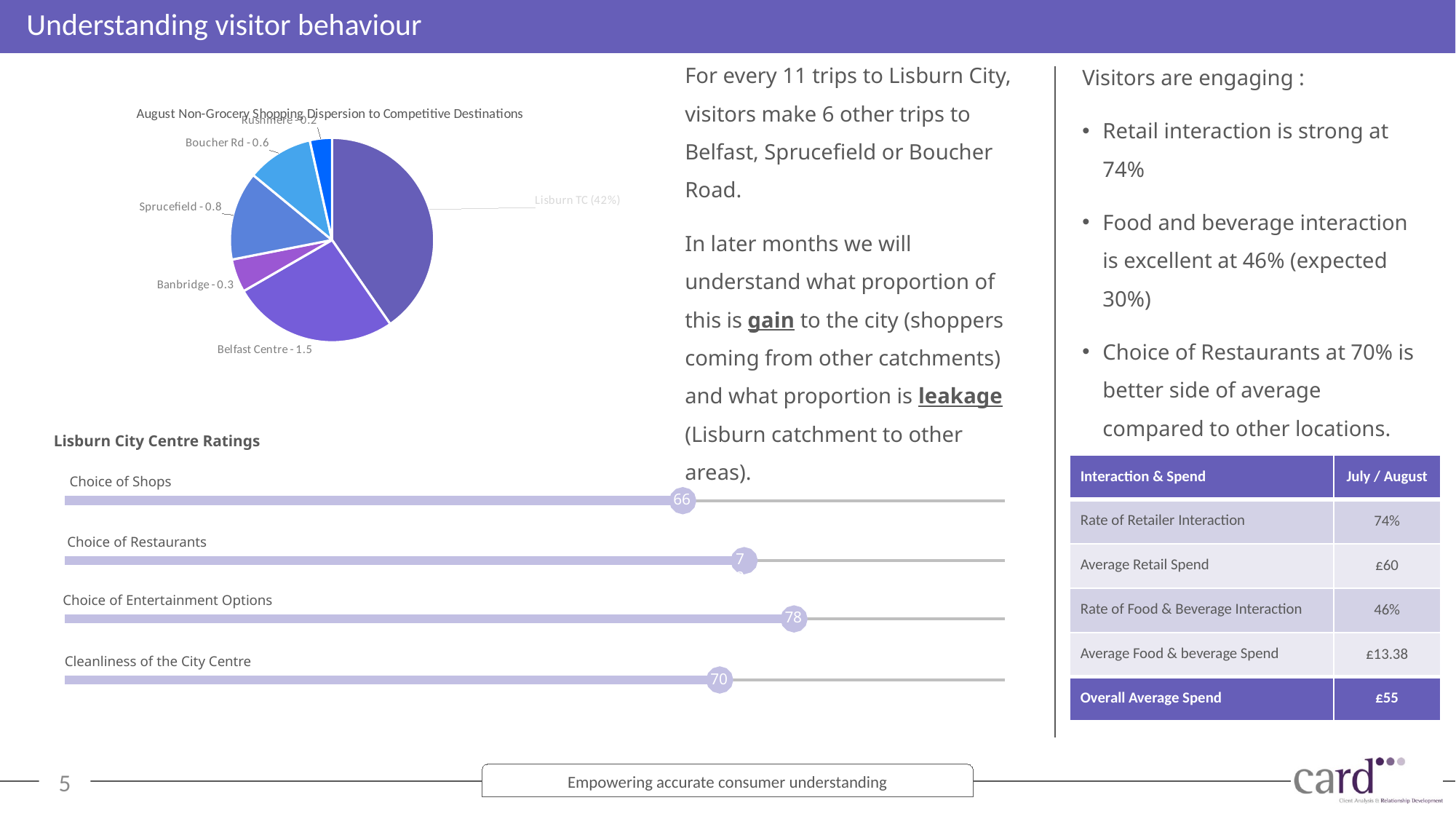
In the 'August Non-Grocery Shopping Dispersion to Competitive Destinations' pie chart, which slice is the largest? Lisburn TC How many slices does the 'August Non-Grocery Shopping Dispersion to Competitive Destinations' pie chart have? 6 In the 'August Non-Grocery Shopping Dispersion to Competitive Destinations' pie chart, what value is shown for Sprucefield? 0.8 In the 'August Non-Grocery Shopping Dispersion to Competitive Destinations' pie chart, what is the difference between the Sprucefield and Boucher Rd values? 0.2 In the 'Lisburn City Centre Ratings' chart, what is the difference between the ratings for Choice of Entertainment Options and Choice of Shops? 12 In the 'Lisburn City Centre Ratings' chart, which category has the highest rating? Choice of Entertainment Options In the 'Lisburn City Centre Ratings' chart, what is the rating for Choice of Entertainment Options? 78 In the 'Lisburn City Centre Ratings' chart, what is the rating for Cleanliness of the City Centre? 70 In the 'August Non-Grocery Shopping Dispersion to Competitive Destinations' pie chart, which is larger, Belfast Centre or Sprucefield? Belfast Centre In the 'August Non-Grocery Shopping Dispersion to Competitive Destinations' pie chart, what value is shown for Belfast Centre? 1.5 In the 'August Non-Grocery Shopping Dispersion to Competitive Destinations' pie chart, what percentage is shown for Lisburn TC? 42% What type of chart is the 'August Non-Grocery Shopping Dispersion to Competitive Destinations' chart? pie chart